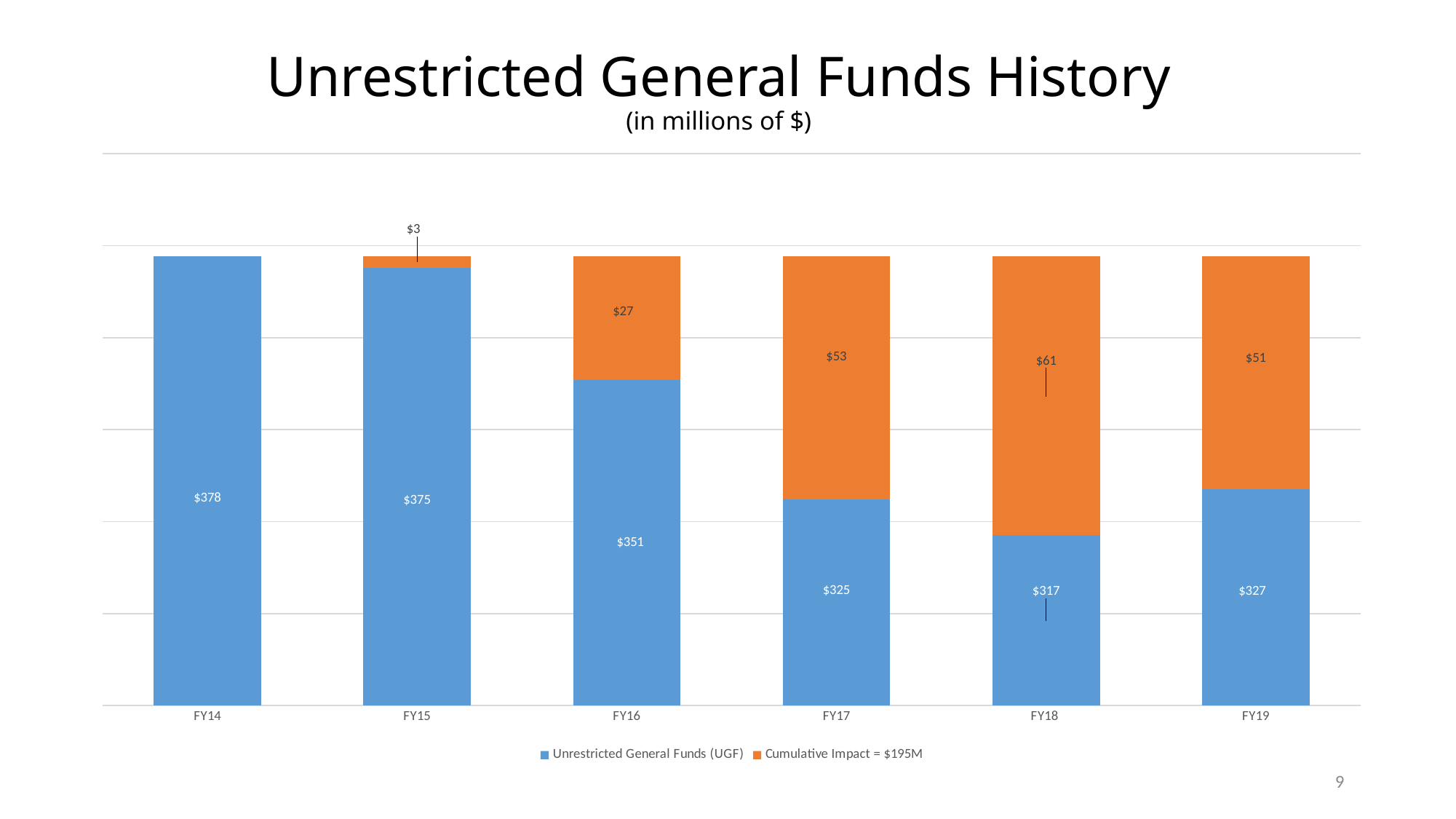
What is the total of the stacked bar for FY17? $378 What total cumulative impact is stated in the legend? $195M Which fiscal year has the lowest Unrestricted General Funds (UGF) value? FY18 How many fiscal years are shown on the x axis? 6 What is the Unrestricted General Funds (UGF) value for FY16? $351 How many series does the legend list? 2 Which fiscal year has the highest Unrestricted General Funds (UGF) value? FY14 What is the Cumulative Impact value for FY18? $61 Is the Cumulative Impact value larger for FY17 or for FY19? FY17 What is the Cumulative Impact value for FY15? $3 What kind of chart is shown on the slide? Stacked bar chart What is the difference between the UGF value for FY14 and the UGF value for FY19? $51